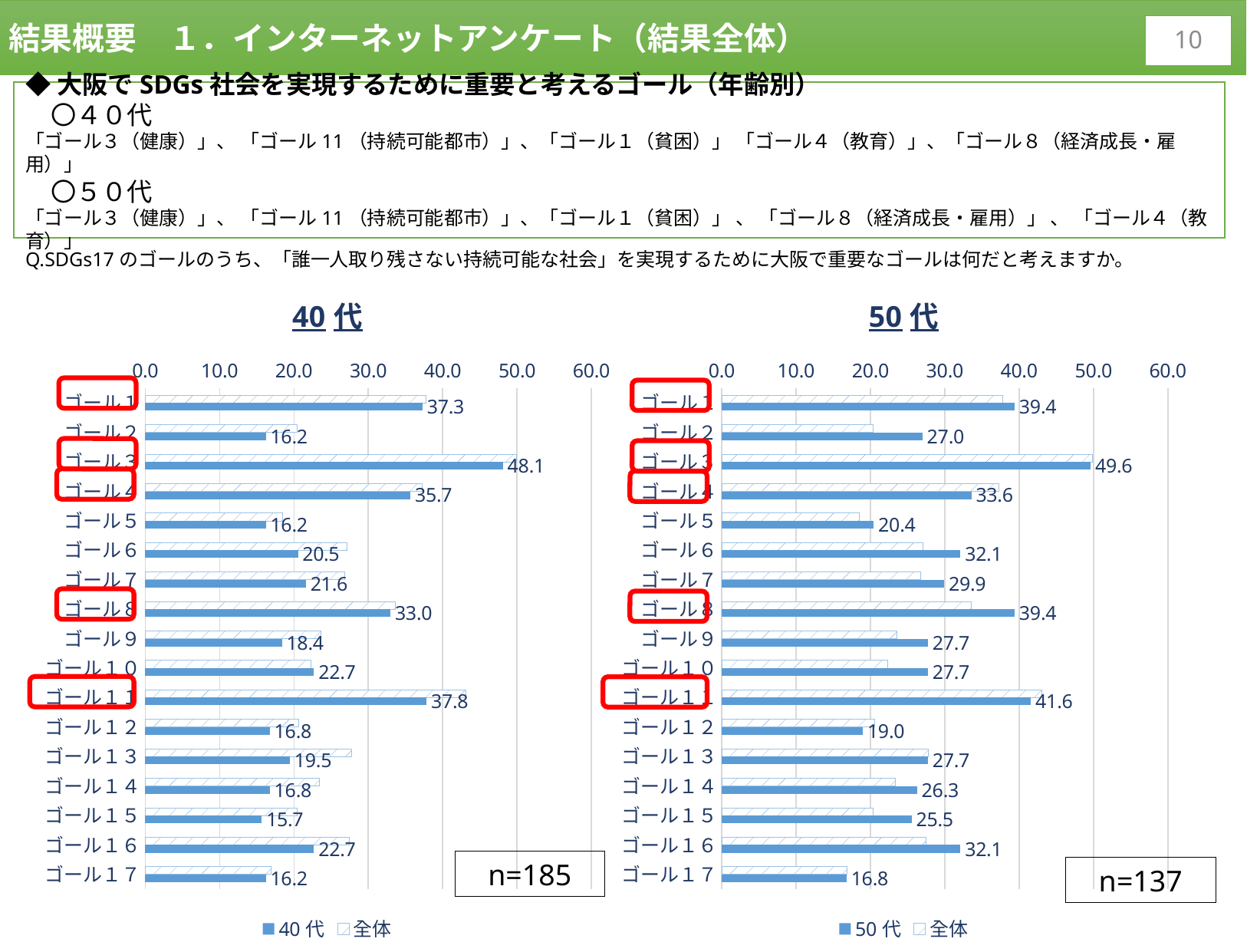
In the 40代 chart, which is larger in the 40代 series: ゴール4 or ゴール8? ゴール4 In the 40代 chart, what is the difference between the 40代 values for ゴール3 and ゴール11? 10.3 How many goal categories are shown in the 50代 chart? 17 In the 40代 chart, what is the value for ゴール8 in the 40代 series? 33.0 In the 40代 chart, what is the value for ゴール3 in the 40代 series? 48.1 In the 50代 chart, what is the difference between the 50代 values for ゴール11 and ゴール1? 2.2 In the 50代 chart, which goal has the highest value in the 50代 series? ゴール3 How many series does the legend of the 40代 chart list? 2 In the 40代 chart, is the 全体 value for ゴール3 greater or less than 40.0? greater In the 50代 chart, which goal has the lowest value in the 50代 series? ゴール17 In the 40代 chart, which goal has the lowest value in the 40代 series? ゴール15 In the 50代 chart, what is the value for ゴール11 in the 50代 series? 41.6